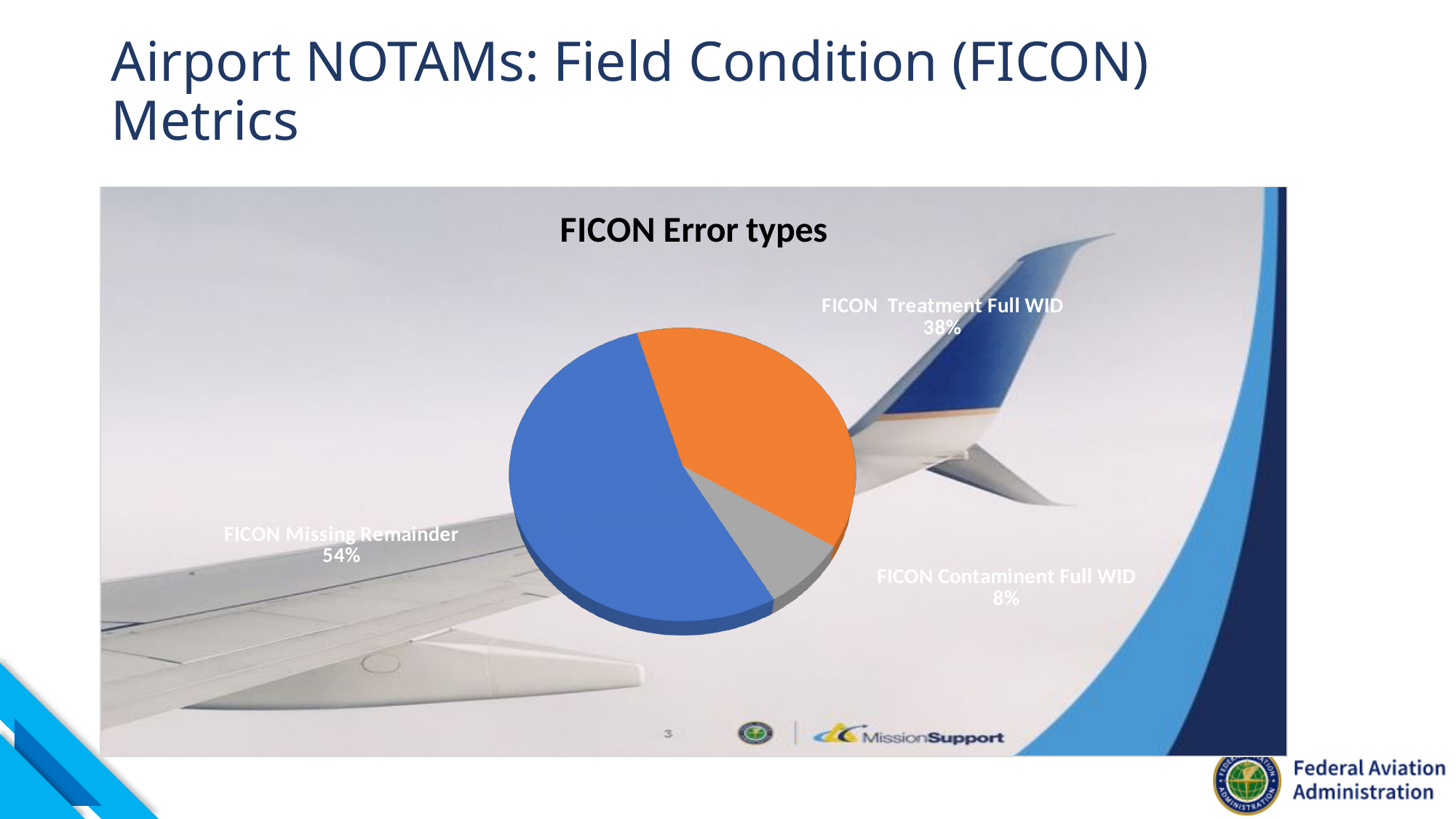
What is the title of the chart? FICON Error types What share of the pie is FICON Missing Remainder? 54% Which category has the smallest slice of the pie? FICON Contaminent Full WID Which category has the largest slice of the pie? FICON Missing Remainder What colour is the FICON Missing Remainder slice? Blue How many slices does the pie chart have? 3 What share of the pie is FICON Treatment Full WID? 38% What type of chart is shown on the slide? Pie chart What is the difference in percentage points between FICON Treatment Full WID and FICON Contaminent Full WID? 30 What is the difference in percentage points between FICON Missing Remainder and FICON Treatment Full WID? 16 What share of the pie is FICON Contaminent Full WID? 8% Which is larger, the share for FICON Treatment Full WID or FICON Contaminent Full WID? FICON Treatment Full WID